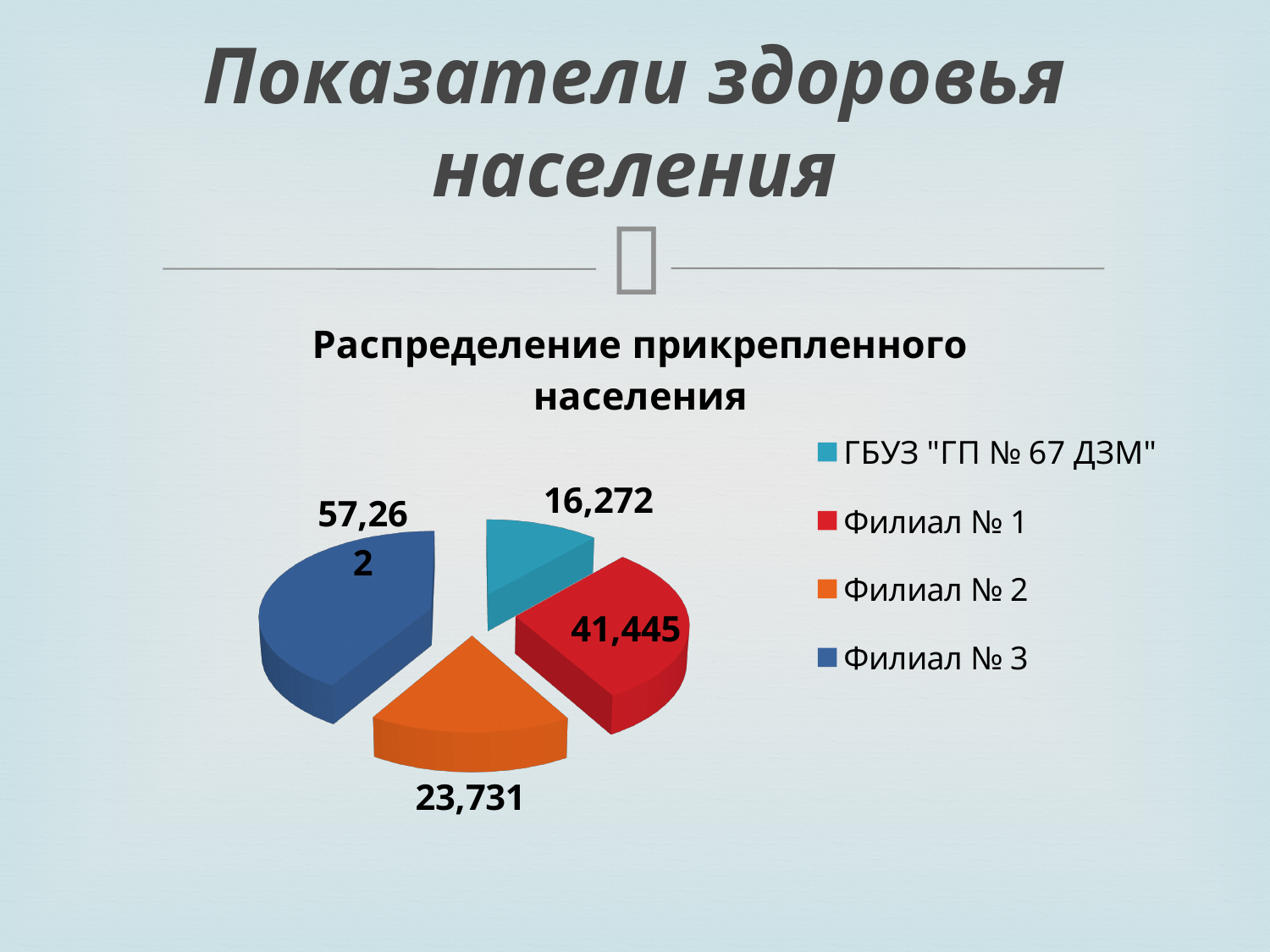
What colour is the slice for Филиал № 2? Orange What is the value for ГБУЗ "ГП № 67 ДЗМ"? 16,272 What is the value for Филиал № 1? 41,445 Which category has the smallest slice of the pie? ГБУЗ "ГП № 67 ДЗМ" What is the difference between the values for Филиал № 1 and ГБУЗ "ГП № 67 ДЗМ"? 25,173 How many slices does the pie chart have? 4 How many entries does the legend list? 4 What is the value for Филиал № 2? 23,731 Which category has the largest slice of the pie? Филиал № 3 Which is larger, the value for Филиал № 1 or the value for Филиал № 2? Филиал № 1 What type of chart is shown on the slide? Pie chart What is the title of the chart? Распределение прикрепленного населения